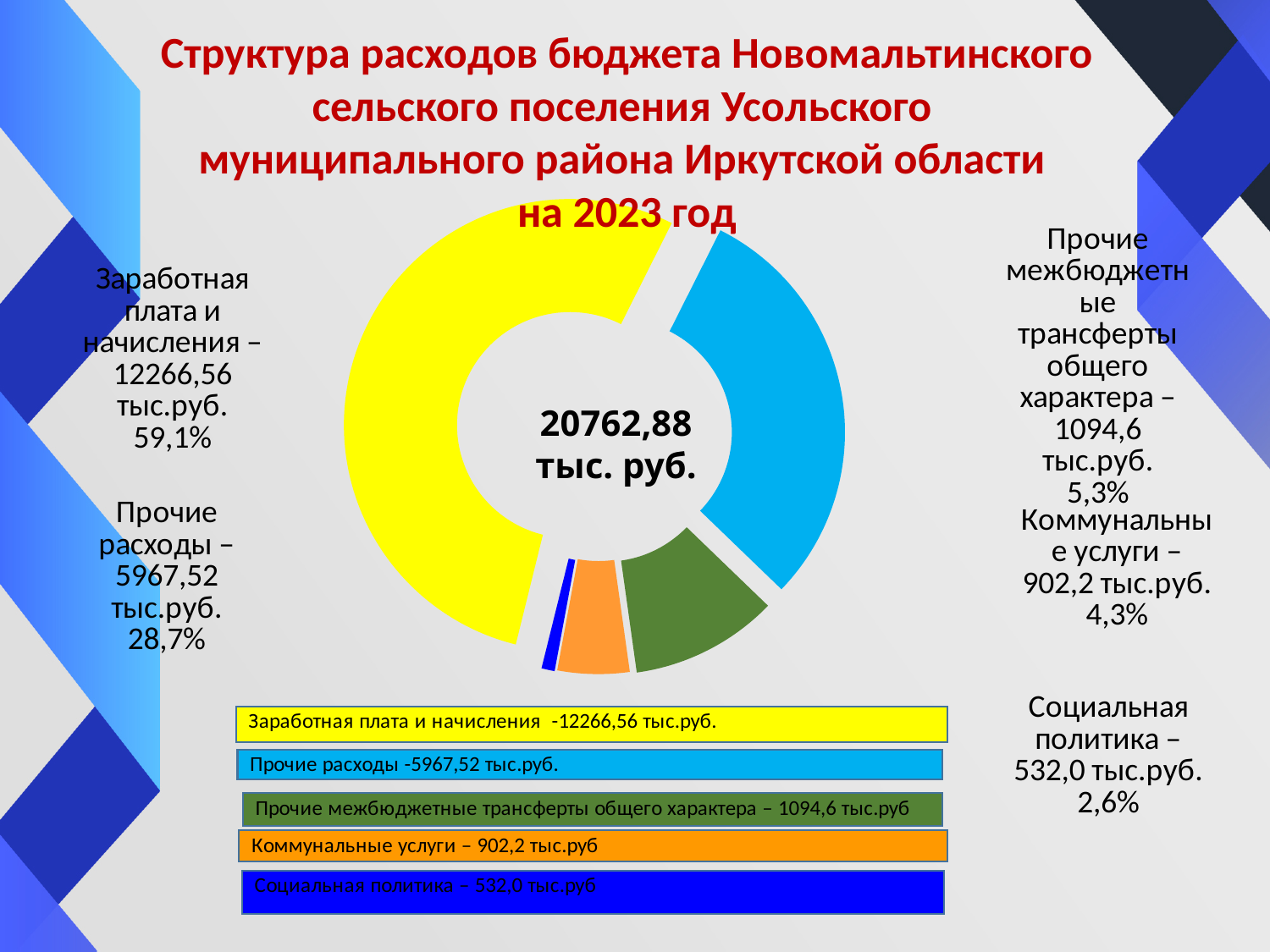
What share of the budget expenditures is Социальная политика? 2,6% What kind of chart is shown on the slide? doughnut (pie) chart Which is larger: Прочие межбюджетные трансферты общего характера or Коммунальные услуги? Прочие межбюджетные трансферты общего характера What colour represents Социальная политика in the chart? dark blue Which category has the largest share of expenditures? Заработная плата и начисления What is the value for Коммунальные услуги? 902,2 тыс.руб. What is the total budget expenditure shown in the centre of the chart? 20762,88 тыс. руб. What is the value for Заработная плата и начисления? 12266,56 тыс.руб. Which category has the smallest share of expenditures? Социальная политика What share of the budget expenditures is Прочие расходы? 28,7% How many expenditure categories does the chart show? 5 What is the difference between Прочие расходы and Прочие межбюджетные трансферты общего характера in тыс.руб.? 4872,92 тыс.руб.